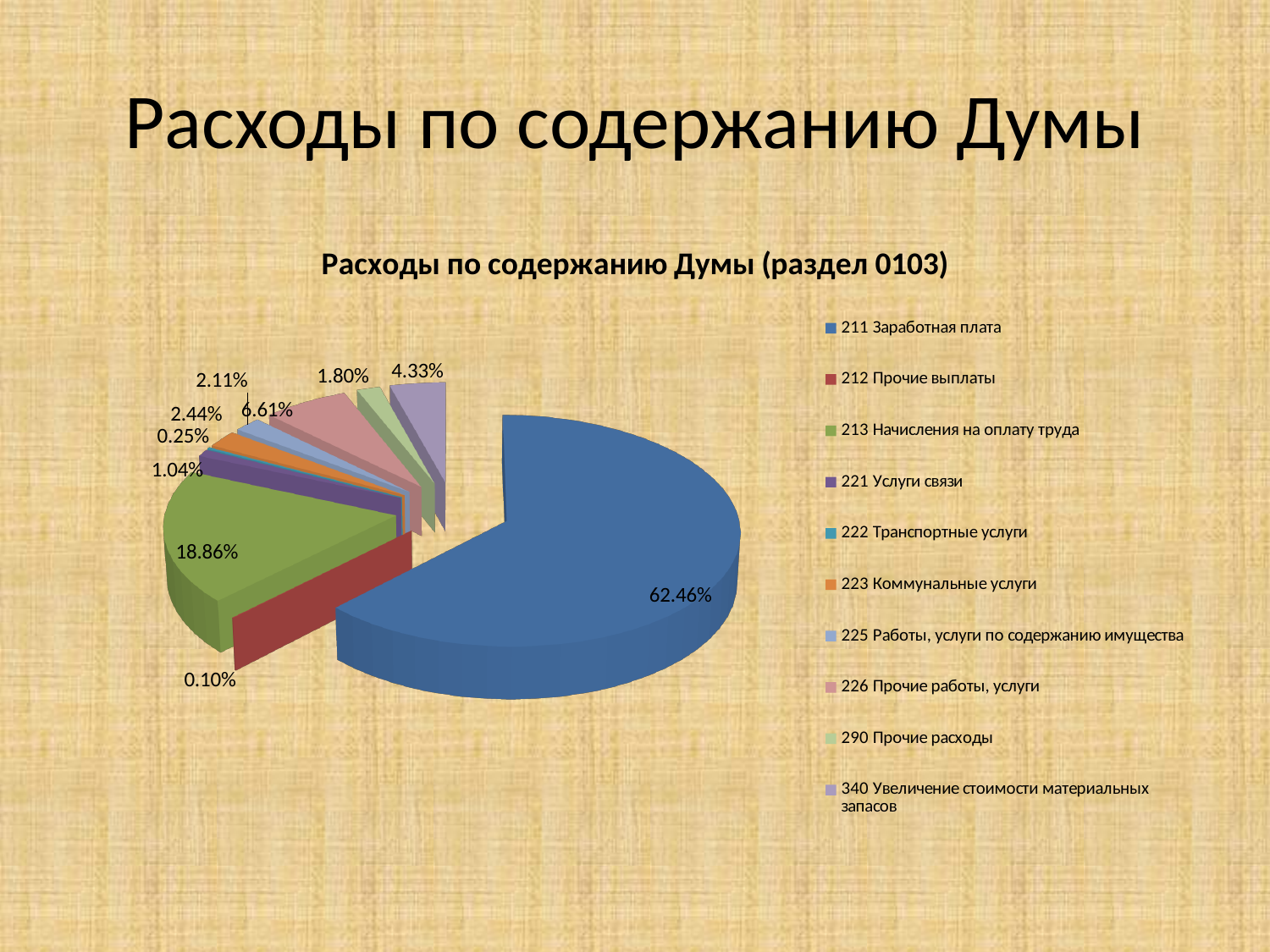
What is the title of the chart? Расходы по содержанию Думы (раздел 0103) What share of the pie is labelled for 226 Прочие работы, услуги? 6.61% What share of the pie is labelled for 340 Увеличение стоимости материальных запасов? 4.33% Which category has the largest slice of the pie? 211 Заработная плата What share of the pie is labelled for 213 Начисления на оплату труда? 18.86% What colour is the slice for 211 Заработная плата? blue Which category has the smallest slice of the pie? 212 Прочие выплаты What is the difference between the shares of 211 Заработная плата and 213 Начисления на оплату труда? 43.60% What type of chart is shown on the slide? pie chart How many entries does the chart legend list? 10 Which is larger, the share for 223 Коммунальные услуги or the share for 225 Работы, услуги по содержанию имущества? 223 Коммунальные услуги